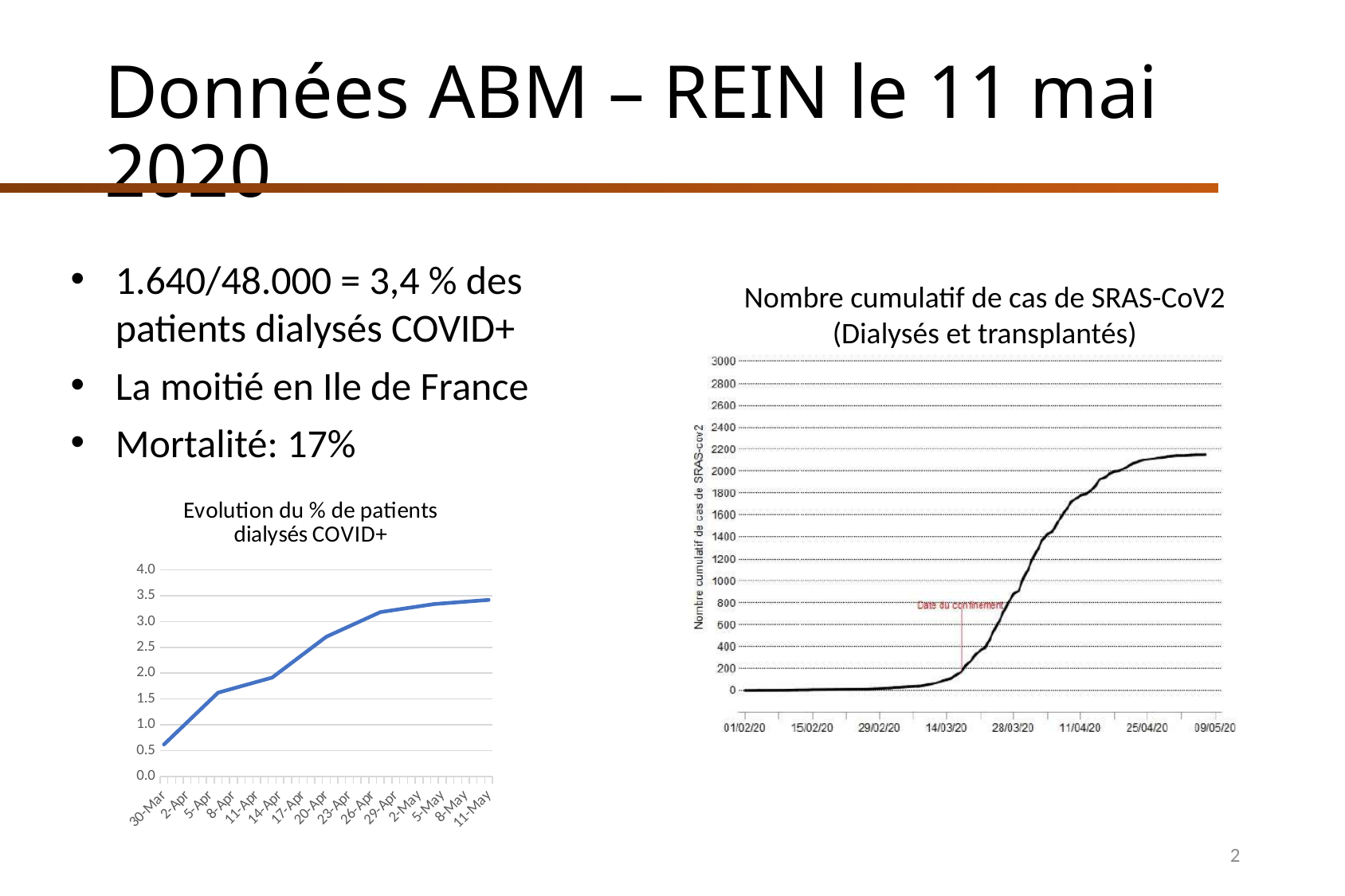
In the 'Nombre cumulatif de cas de SRAS-CoV2' chart, do the values rise or fall from 01/02/20 to 09/05/20? rise In the 'Evolution du % de patients dialysés COVID+' chart, is the value for 11-May greater or less than 3.0? greater In the 'Nombre cumulatif de cas de SRAS-CoV2' chart, is the value for 28/03/20 greater or less than 600? greater In the 'Evolution du % de patients dialysés COVID+' chart, is the value for 20-Apr greater or less than 2.5? greater What kind of chart is the 'Evolution du % de patients dialysés COVID+' chart? line chart What is the title of the chart on the right of the slide? Nombre cumulatif de cas de SRAS-CoV2 (Dialysés et transplantés) In the 'Evolution du % de patients dialysés COVID+' chart, do the values rise or fall from 30-Mar to 11-May? rise What kind of chart is the 'Nombre cumulatif de cas de SRAS-CoV2' chart? line chart What event is marked by the red annotation in the 'Nombre cumulatif de cas de SRAS-CoV2' chart? Date du confinement